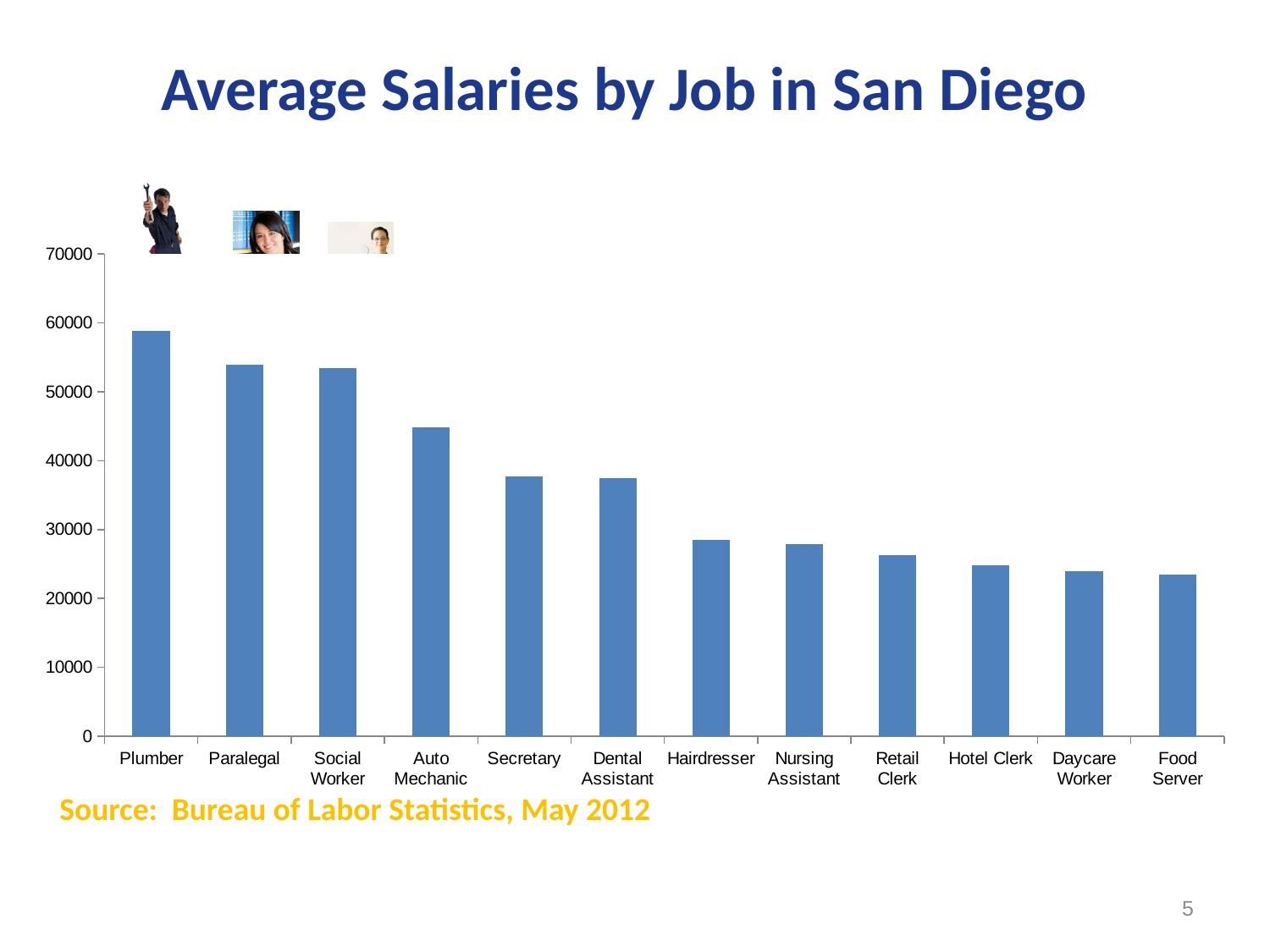
Is the value for Secretary greater or less than 40000? less Is the value for Food Server greater or less than 20000? greater Is the value for Hairdresser greater or less than 30000? less What is the title of the chart? Average Salaries by Job in San Diego Which job has the highest average salary in the chart? Plumber Which has the larger value, Auto Mechanic or Hairdresser? Auto Mechanic What source is cited below the chart? Bureau of Labor Statistics, May 2012 How many jobs are shown on the x axis of the chart? 12 Do the values rise or fall moving from left to right along the x axis? fall What kind of chart is shown on the slide? bar chart